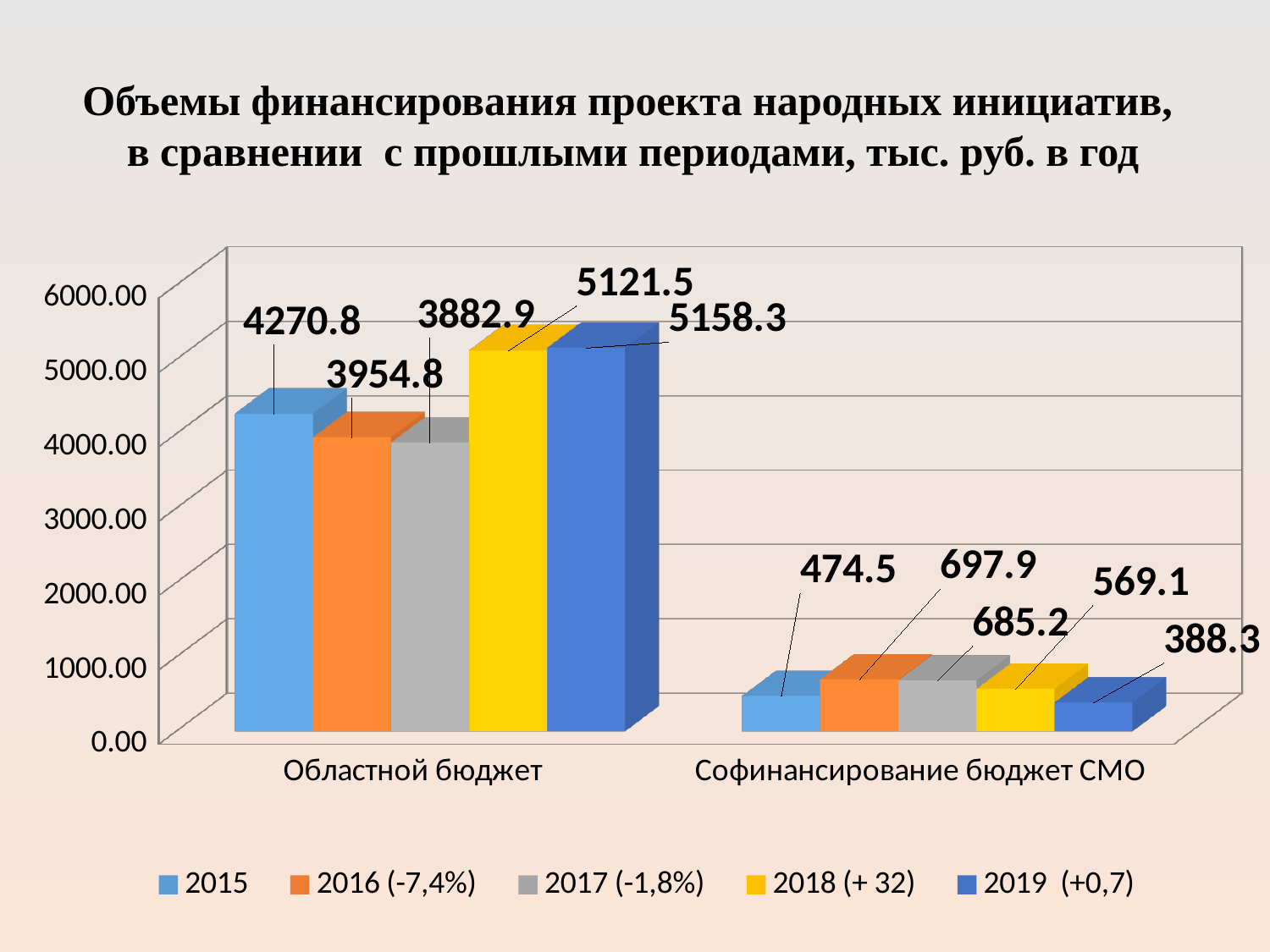
Which year has the highest value in the Областной бюджет category? 2019 What is the value for 2017 in the Областной бюджет category? 3882.9 What kind of chart is shown on the slide? bar chart Is the 2016 value for Областной бюджет greater or less than 4000.00? less In the Софинансирование бюджет СМО category, which is larger: the 2016 value or the 2018 value? 2016 What is the difference between the 2018 and 2017 values in the Областной бюджет category? 1238.6 How many series does the legend list? 5 What colour are the bars for the 2018 series? yellow How many categories are shown on the x axis? 2 Which year has the lowest value in the Софинансирование бюджет СМО category? 2019 What is the value for 2019 in the Софинансирование бюджет СМО category? 388.3 What is the value for 2015 in the Областной бюджет category? 4270.8